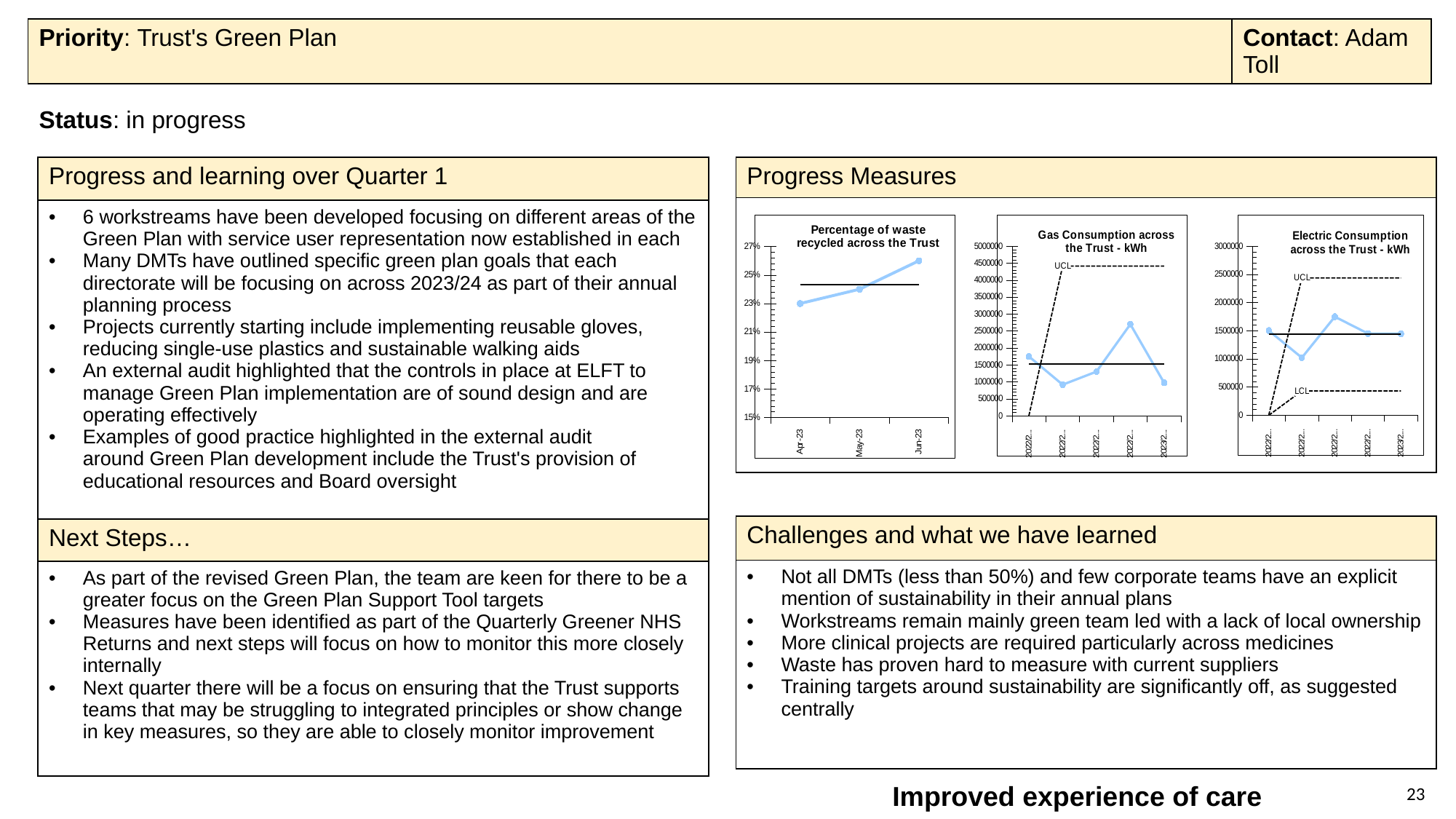
In the 'Percentage of waste recycled across the Trust' chart, do the values rise or fall from Apr-23 to Jun-23? rise In the 'Electric Consumption across the Trust - kWh' chart, is the highest plotted point greater or less than 2000000? less How many data points are plotted on the 'Gas Consumption across the Trust - kWh' chart? 5 In the 'Percentage of waste recycled across the Trust' chart, which month has the lowest value? Apr-23 In the 'Percentage of waste recycled across the Trust' chart, which month has the highest value? Jun-23 In the 'Gas Consumption across the Trust - kWh' chart, is the highest plotted point greater or less than 2000000? greater What is the title of the rightmost chart on the slide? Electric Consumption across the Trust - kWh How many charts are shown in the 'Progress Measures' section of the slide? 3 How many months are plotted on the 'Percentage of waste recycled across the Trust' chart? 3 In the 'Percentage of waste recycled across the Trust' chart, is the value for Jun-23 greater or less than 25%? greater What kind of chart is the 'Percentage of waste recycled across the Trust' chart? line chart